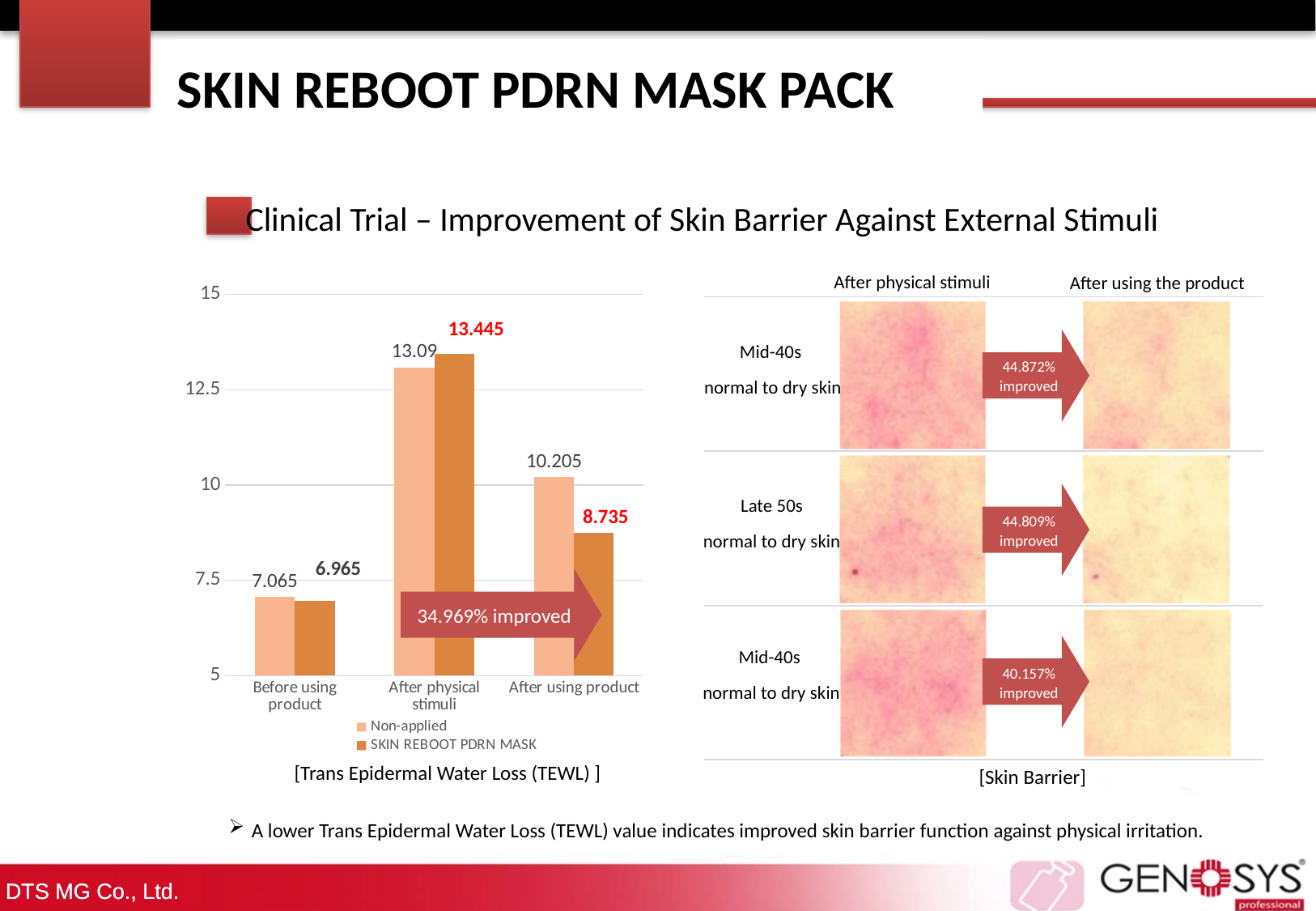
What type of chart is shown on the slide? bar chart What is the difference between the Non-applied and SKIN REBOOT PDRN MASK values for 'After using product'? 1.47 Which category has the highest Non-applied value? After physical stimuli How many categories are shown on the x axis of the chart? 3 What is the Non-applied value for 'After using product'? 10.205 For 'After using product', which is larger: the Non-applied value or the SKIN REBOOT PDRN MASK value? Non-applied How many series does the chart legend list? 2 What is the Non-applied value for 'Before using product'? 7.065 What is the caption shown below the chart? [Trans Epidermal Water Loss (TEWL) ] Which category has the lowest SKIN REBOOT PDRN MASK value? Before using product What is the SKIN REBOOT PDRN MASK value for 'After physical stimuli'? 13.445 What is the SKIN REBOOT PDRN MASK value for 'After using product'? 8.735